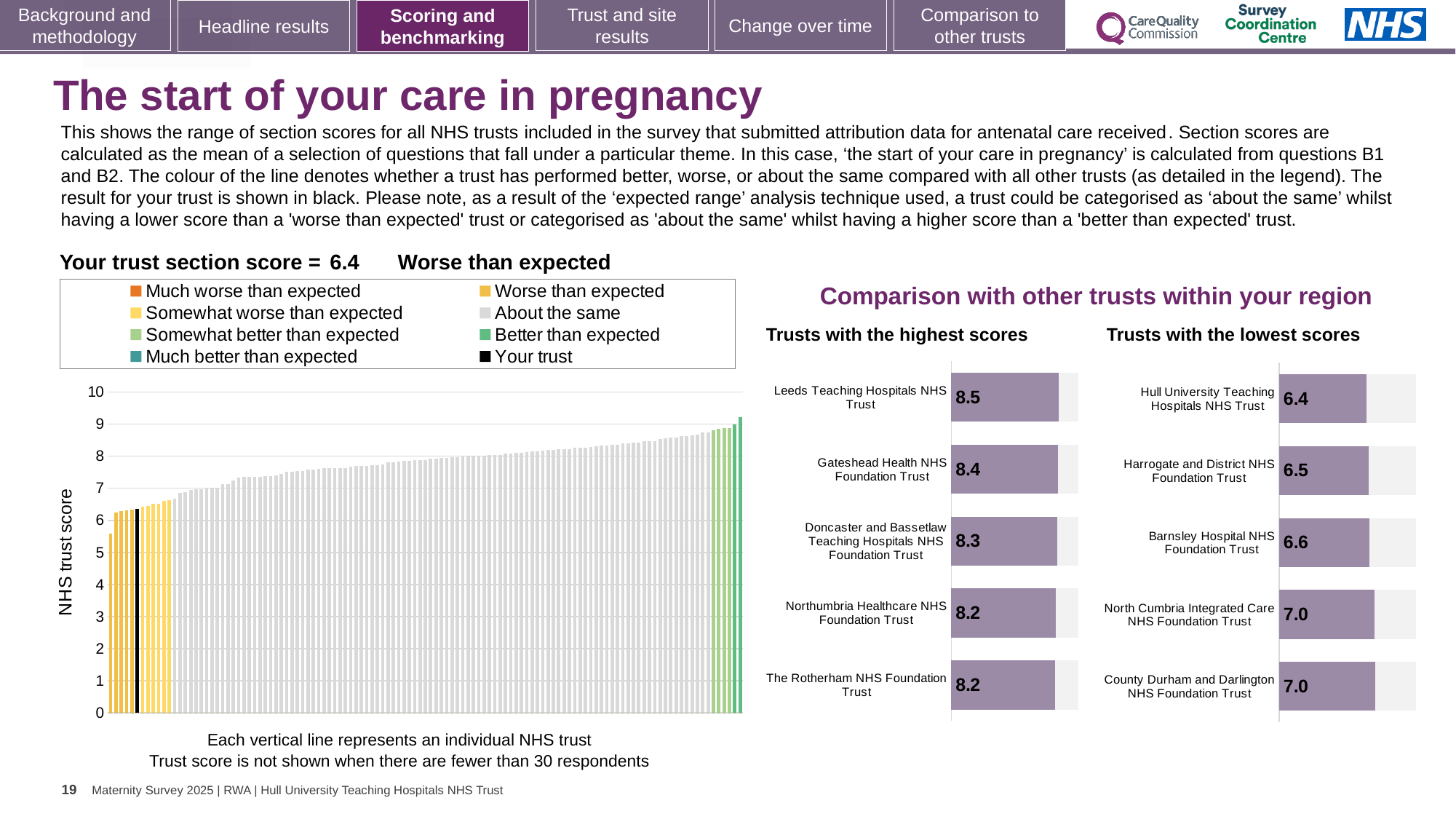
In the 'Trusts with the highest scores' chart, what is the score for Leeds Teaching Hospitals NHS Trust? 8.5 In the 'Trusts with the highest scores' chart, which trust has the highest score? Leeds Teaching Hospitals NHS Trust In the 'Trusts with the lowest scores' chart, which has the higher score: Barnsley Hospital NHS Foundation Trust or Harrogate and District NHS Foundation Trust? Barnsley Hospital NHS Foundation Trust In the 'Trusts with the lowest scores' chart, what is the difference between the scores of County Durham and Darlington NHS Foundation Trust and Hull University Teaching Hospitals NHS Trust? 0.6 How many trusts are shown in the 'Trusts with the lowest scores' chart? 5 In the 'Trusts with the highest scores' chart, what is the difference between the scores of Leeds Teaching Hospitals NHS Trust and Northumbria Healthcare NHS Foundation Trust? 0.3 In the 'Trusts with the lowest scores' chart, what is the score for Harrogate and District NHS Foundation Trust? 6.5 In the large 'NHS trust score' chart on the left, do the values rise or fall from left to right? rise In the 'Trusts with the highest scores' chart, what is the score for Doncaster and Bassetlaw Teaching Hospitals NHS Foundation Trust? 8.3 How many entries does the legend of the large 'NHS trust score' chart on the left list? 8 In the 'Trusts with the lowest scores' chart, which trust has the lowest score? Hull University Teaching Hospitals NHS Trust In the large 'NHS trust score' chart on the left, is the value for the black bar (your trust) greater or less than 7? less